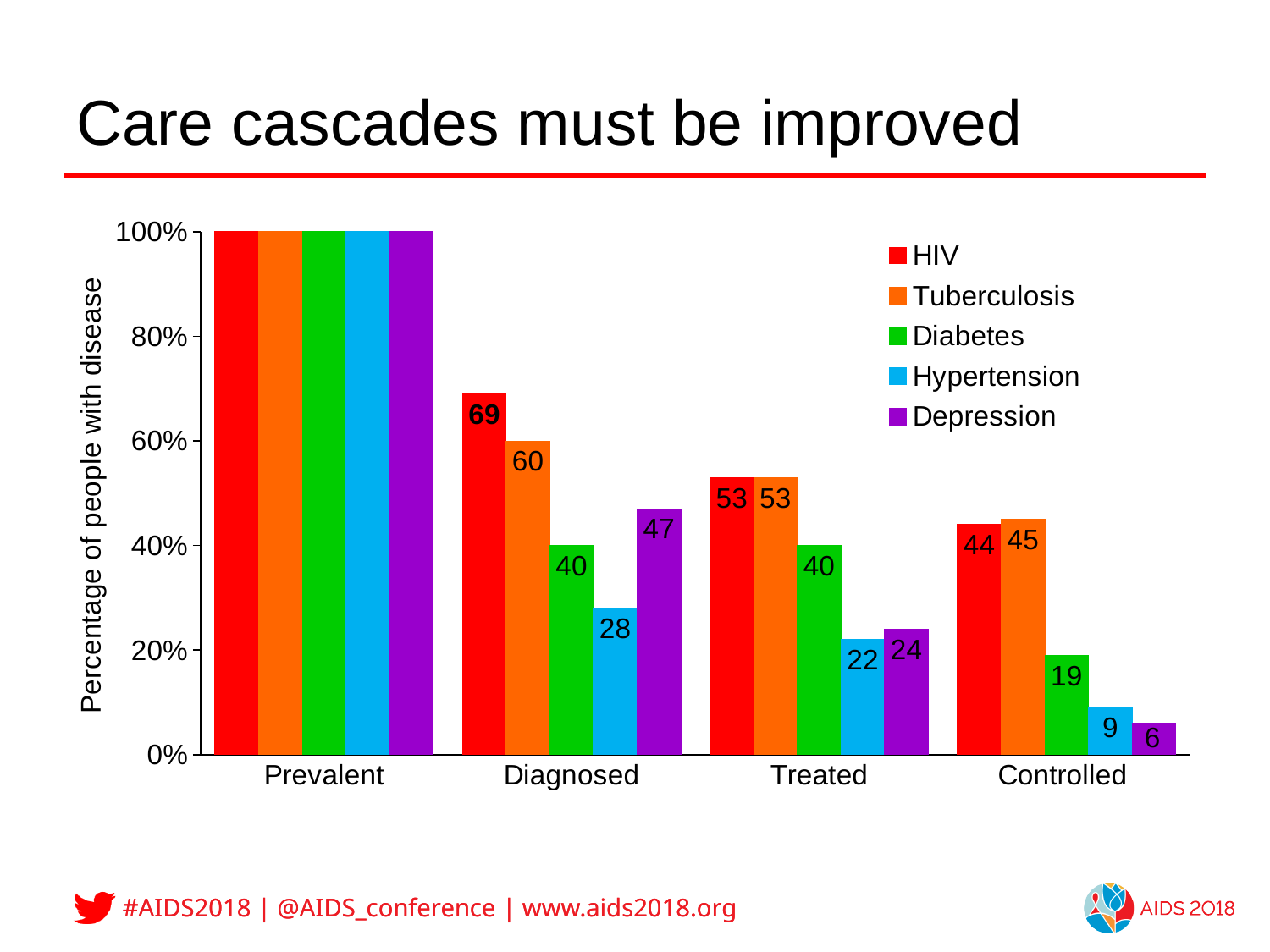
In the Diagnosed category, which is larger: the value for Tuberculosis or the value for Depression? Tuberculosis Which series has the lowest value in the Controlled category? Depression What kind of chart is shown on the slide? Bar chart What is the title of the slide containing the chart? Care cascades must be improved What is the value for Hypertension in the Controlled category? 9 What is the difference between the Tuberculosis and Diabetes values in the Treated category? 13 Which series has the highest value in the Diagnosed category? HIV How many series does the legend list? 5 Do the values for Diabetes rise or fall from Diagnosed to Controlled? Fall What is the value for HIV in the Diagnosed category? 69 What is the value for Depression in the Diagnosed category? 47 How many categories are shown on the x axis? 4